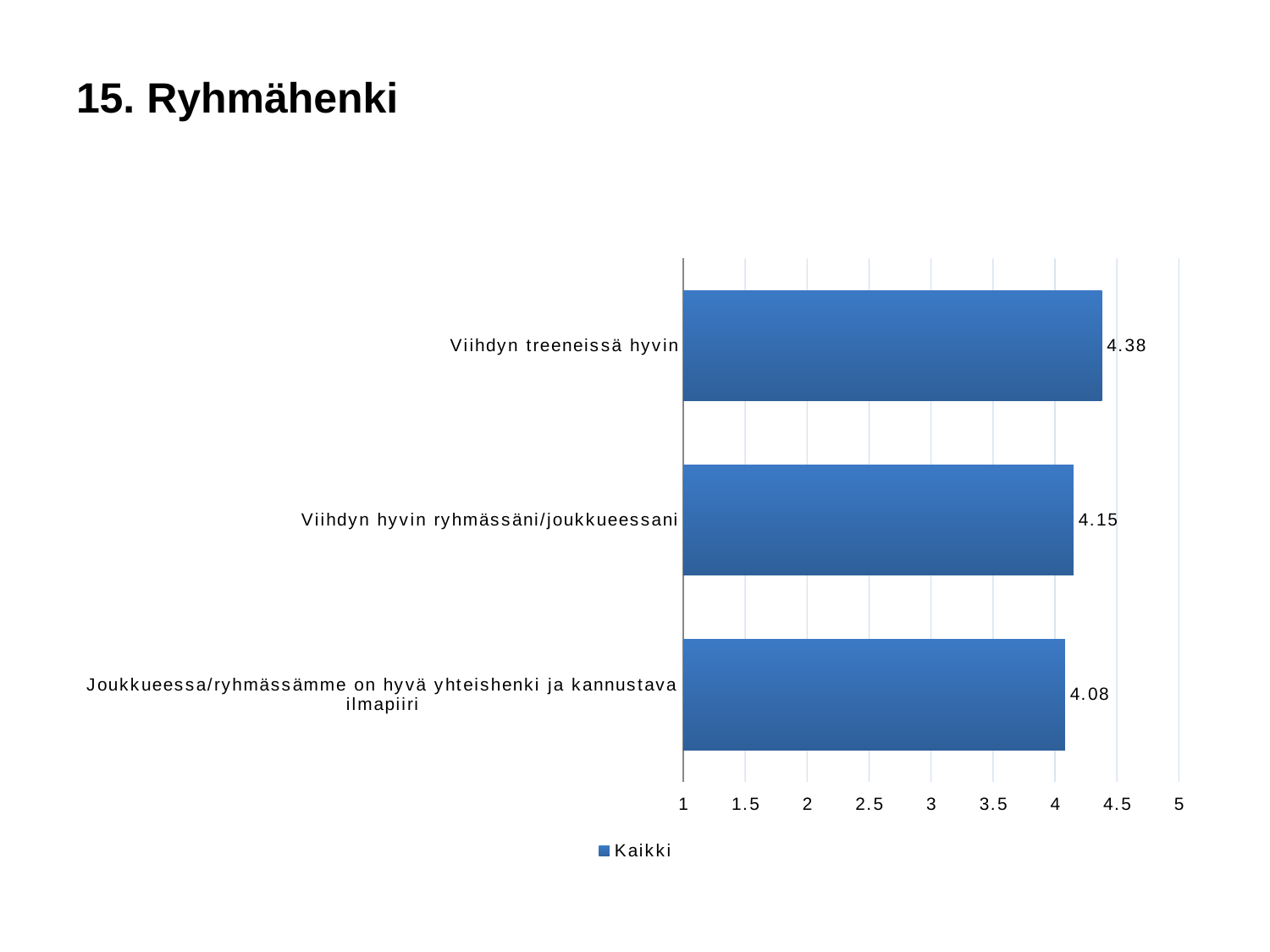
What is the value for "Viihdyn treeneissä hyvin"? 4.38 Which category has the highest value? Viihdyn treeneissä hyvin How many categories are shown in the chart? 3 What is the difference between the values for "Viihdyn treeneissä hyvin" and "Viihdyn hyvin ryhmässäni/joukkueessani"? 0.23 What is the value for "Viihdyn hyvin ryhmässäni/joukkueessani"? 4.15 How many series does the legend list? 1 What kind of chart is shown on the slide? bar chart What is the value for "Joukkueessa/ryhmässämme on hyvä yhteishenki ja kannustava ilmapiiri"? 4.08 What is the difference between the values for "Viihdyn treeneissä hyvin" and "Joukkueessa/ryhmässämme on hyvä yhteishenki ja kannustava ilmapiiri"? 0.30 Which category has the lowest value? Joukkueessa/ryhmässämme on hyvä yhteishenki ja kannustava ilmapiiri Is the value for "Viihdyn treeneissä hyvin" greater or less than 4.5? less Which is larger: the value for "Viihdyn hyvin ryhmässäni/joukkueessani" or for "Joukkueessa/ryhmässämme on hyvä yhteishenki ja kannustava ilmapiiri"? Viihdyn hyvin ryhmässäni/joukkueessani